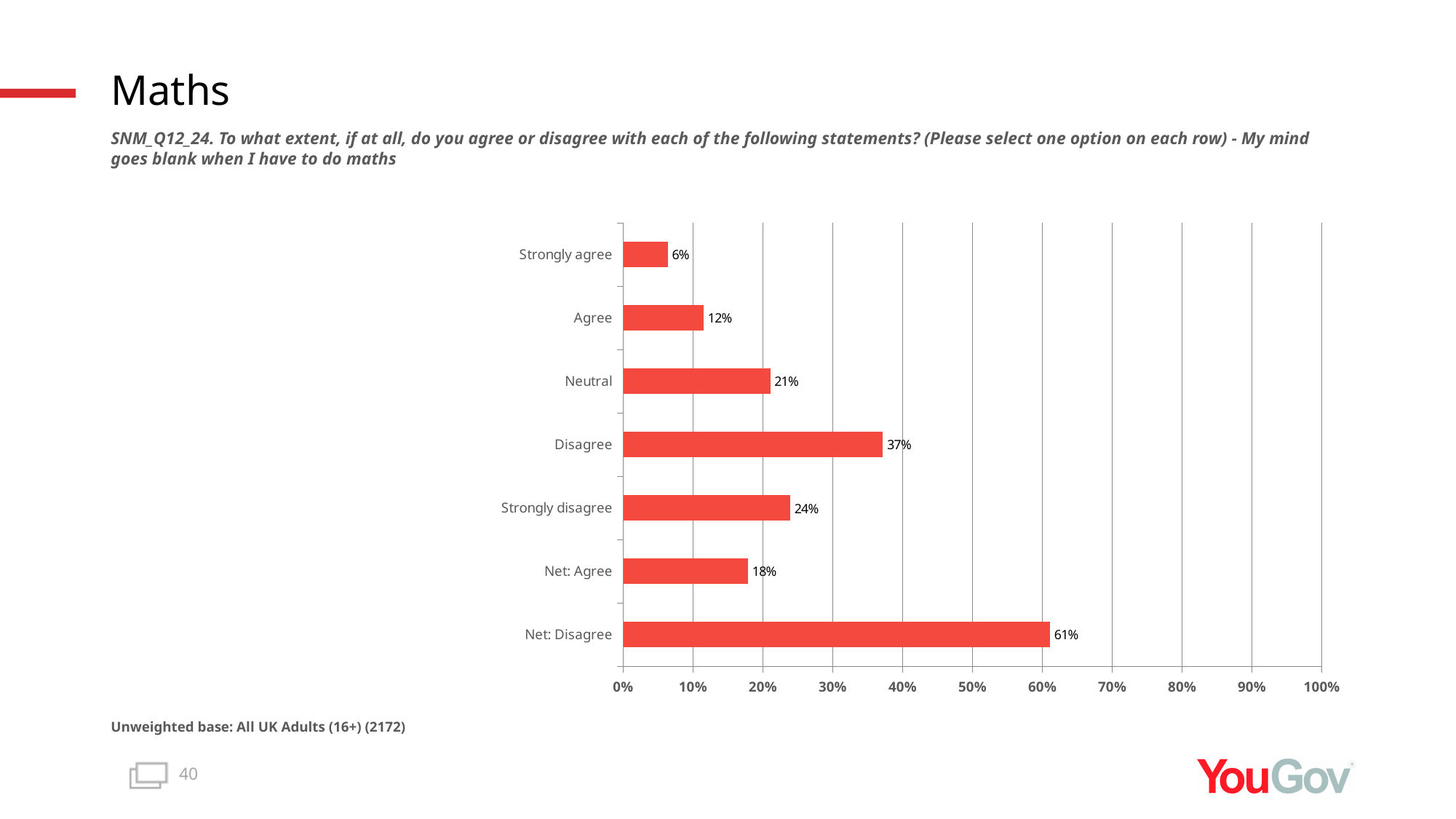
Is the value for 'Disagree' greater or less than 40%? less Which category has the lowest value? Strongly agree What is the unweighted base stated below the chart? All UK Adults (16+) (2172) Which is larger, 'Neutral' or 'Strongly disagree'? Strongly disagree What kind of chart is shown on the slide? bar chart What is the difference between 'Net: Disagree' and 'Net: Agree'? 43% Which category has the highest value? Net: Disagree How many categories are shown on the chart? 7 What percentage of respondents selected 'Disagree'? 37% What is the value for 'Net: Disagree'? 61% What is the difference between 'Agree' and 'Strongly agree'? 6% What is the value shown for 'Strongly agree'? 6%